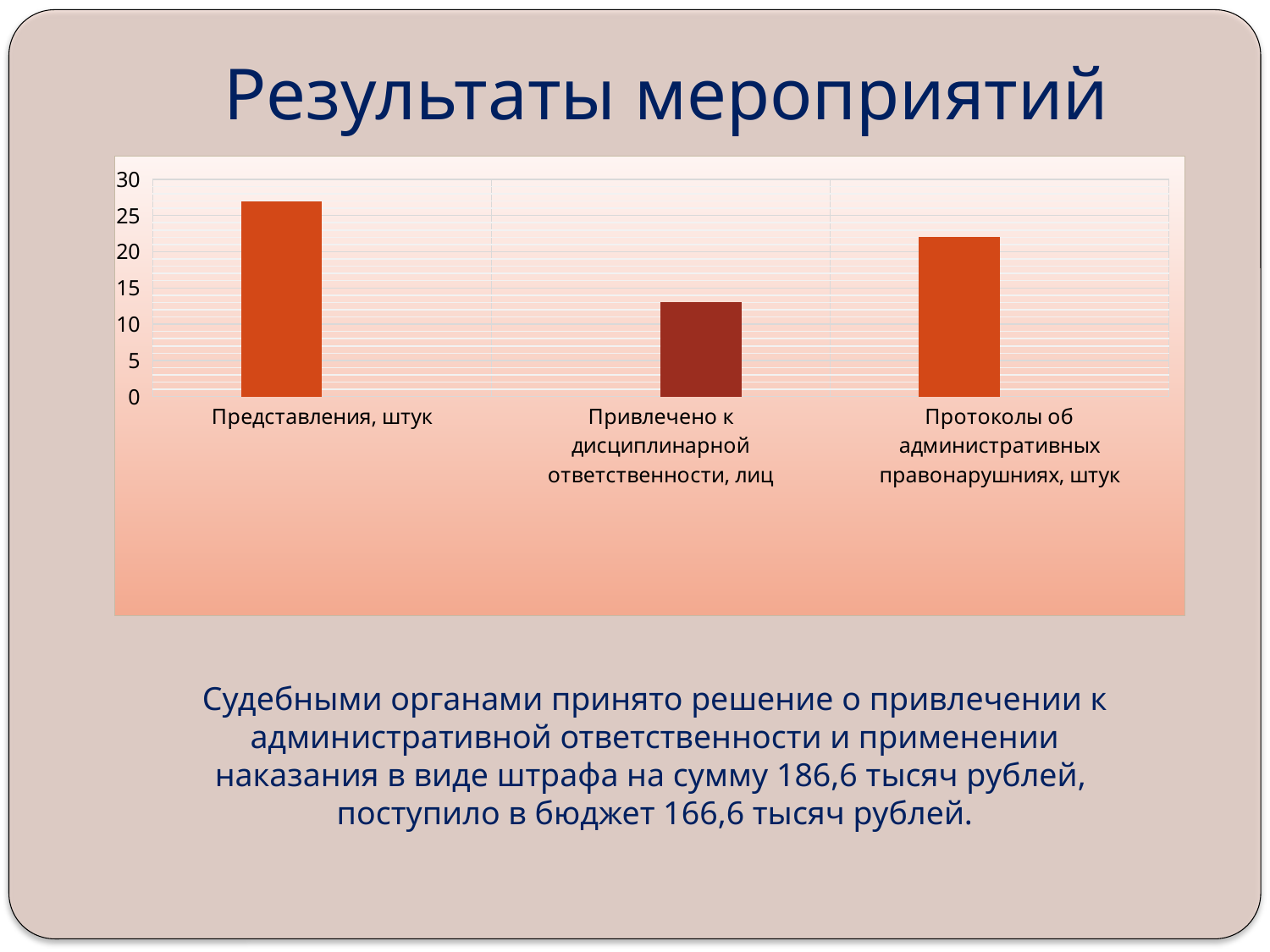
What is the title of the slide containing the chart? Результаты мероприятий How many categories are plotted in the chart? 3 Which is larger: the value for Представления, штук or the value for Протоколы об административных правонарушниях, штук? Представления, штук Which category has the highest bar? Представления, штук Which category has the lowest bar? Привлечено к дисциплинарной ответственности, лиц Is the value for Представления, штук greater or less than 25? greater What is the maximum value shown on the vertical axis of the chart? 30 Is the value for Протоколы об административных правонарушниях, штук greater or less than 25? less What kind of chart is shown on the slide? bar chart Is the value for Привлечено к дисциплинарной ответственности, лиц greater or less than 15? less